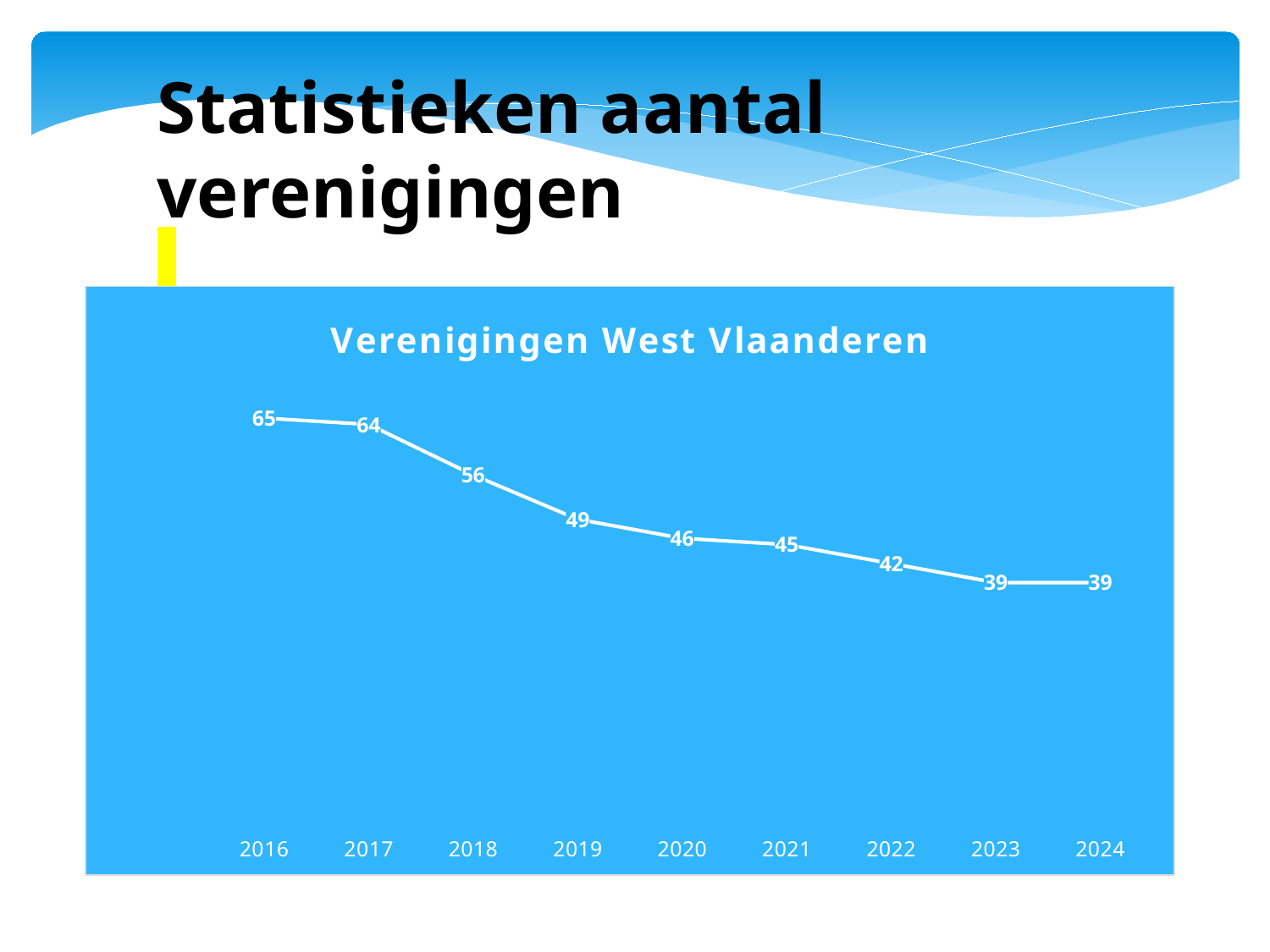
Which year has the highest value? 2016 What is the difference between the values for 2016 and 2024? 26 What kind of chart is this? line chart How many years are plotted on the x axis? 9 What is the lowest value shown on the chart? 39 Which is larger, the value for 2018 or the value for 2020? 2018 Do the values rise or fall from 2016 to 2024? fall What is the title of the chart? Verenigingen West Vlaanderen What is the difference between the values for 2017 and 2018? 8 What is the value for 2016? 65 What is the value for 2019? 49 What is the value for 2022? 42